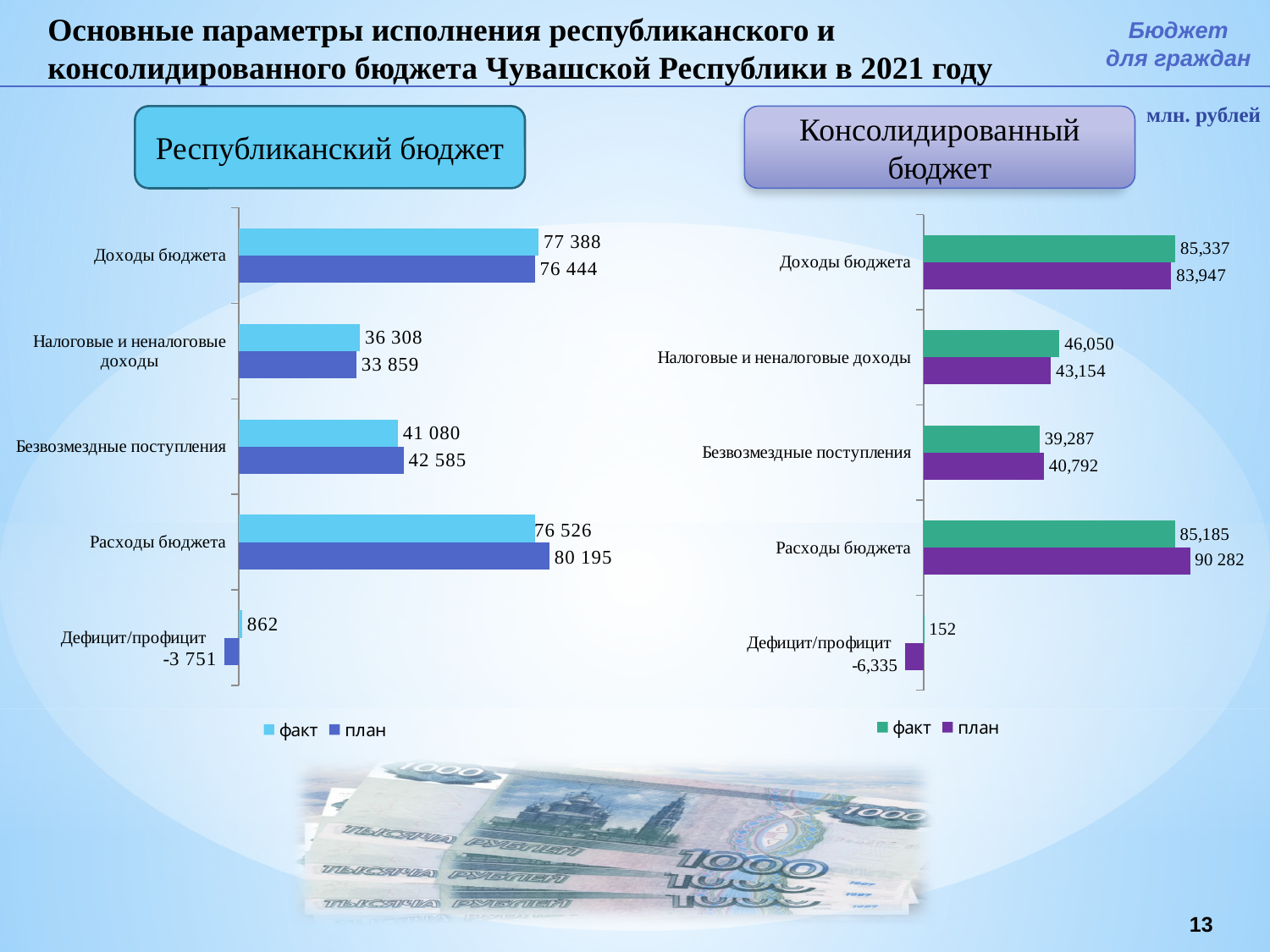
In the Консолидированный бюджет chart, what is the план value for Дефицит/профицит? -6,335 In the Республиканский бюджет chart, which is larger for Безвозмездные поступления: факт or план? план In the Консолидированный бюджет chart, which category has the highest план value? Расходы бюджета How many categories does the Консолидированный бюджет chart show? 5 In the Республиканский бюджет chart, what is the difference between the план and факт values for Расходы бюджета? 3 669 How many series does the legend of the Республиканский бюджет chart list? 2 In the Консолидированный бюджет chart, what is the факт value for Налоговые и неналоговые доходы? 46,050 In the Республиканский бюджет chart, what is the факт value for Доходы бюджета? 77 388 What type of chart is the Консолидированный бюджет chart? Bar chart In the Республиканский бюджет chart, which category has the lowest план value? Дефицит/профицит In the Консолидированный бюджет chart, what is the difference between the факт and план values for Доходы бюджета? 1,390 In the Республиканский бюджет chart, what is the план value for Расходы бюджета? 80 195